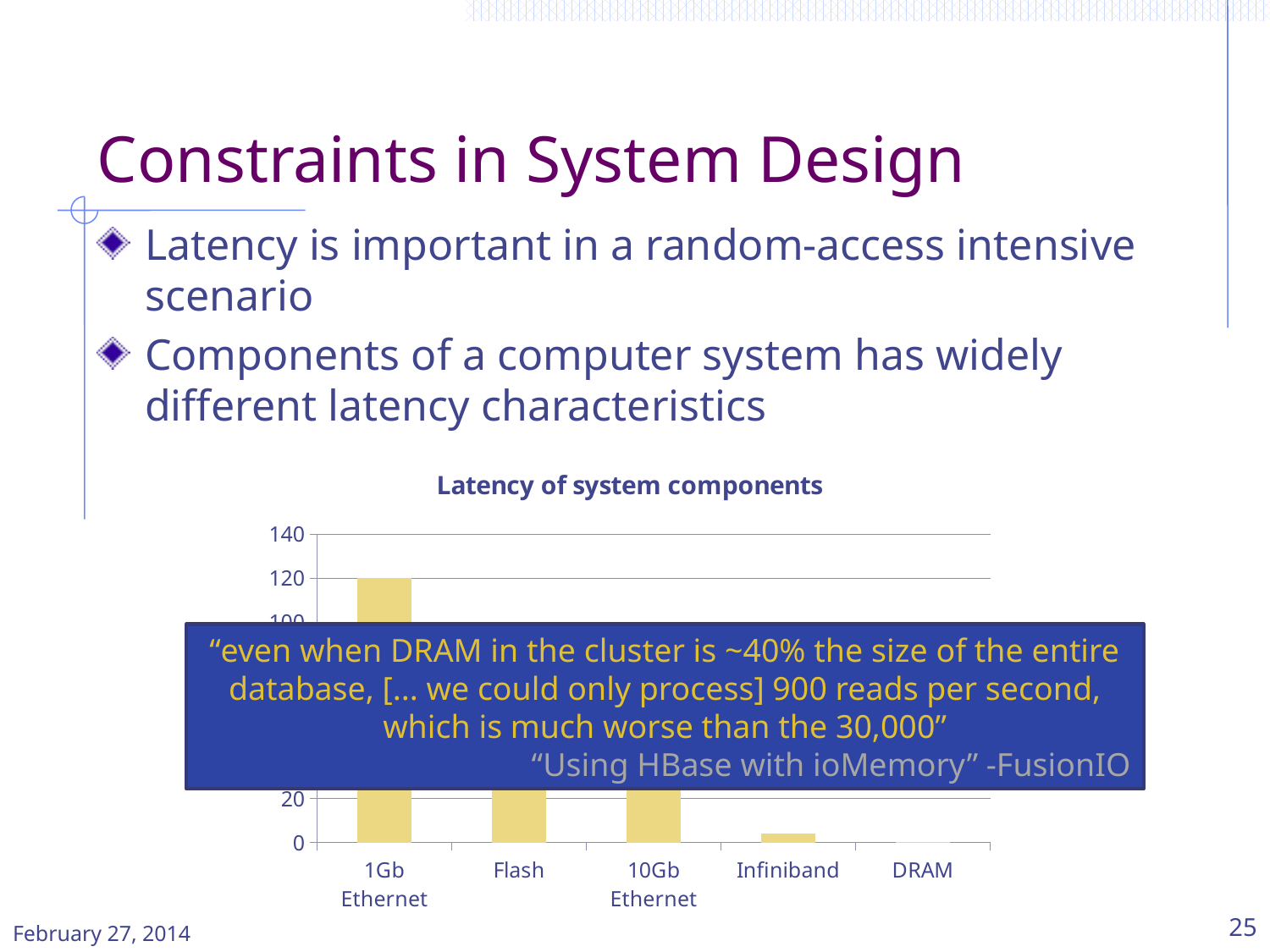
Is the value for DRAM greater or less than 20? less What is the title of the chart? Latency of system components Is the value for 1Gb Ethernet greater or less than 100? greater How many system components are shown on the x axis of the chart? 5 Is the value for Infiniband greater or less than 20? less Which has the larger latency, 1Gb Ethernet or Infiniband? 1Gb Ethernet Which component has the highest latency in the chart? 1Gb Ethernet What kind of chart is shown on the slide? bar chart Which has the larger latency, Infiniband or DRAM? Infiniband What is the latency value shown for 1Gb Ethernet? 120 Do the latency values generally rise or fall from left to right along the x axis? fall Which component has the lowest latency in the chart? DRAM